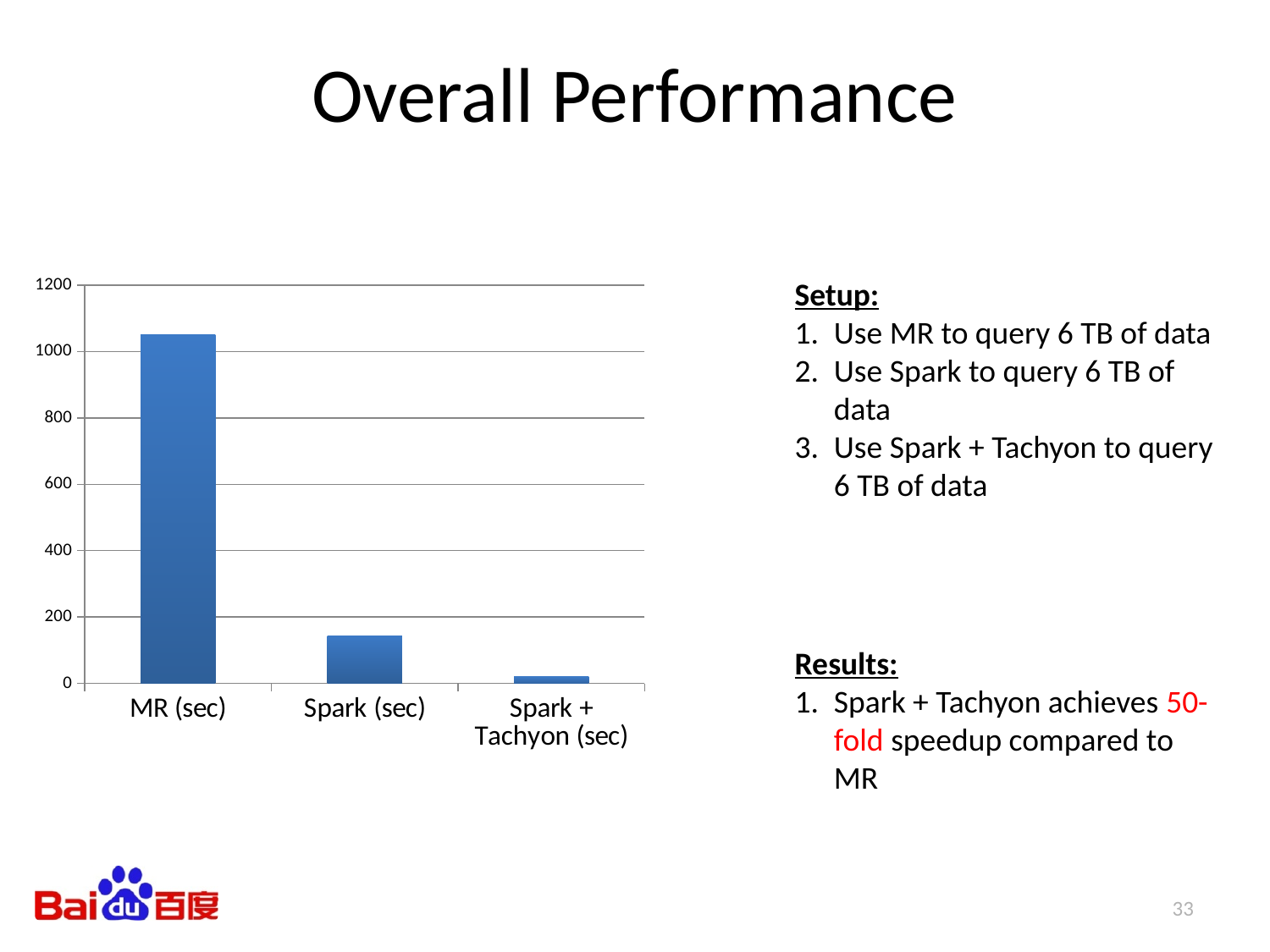
Which category has the lowest value in the chart? Spark + Tachyon (sec) Which is larger, the value for MR (sec) or the value for Spark (sec)? MR (sec) Which is larger, the value for Spark (sec) or the value for Spark + Tachyon (sec)? Spark (sec) What is the highest tick value shown on the vertical axis of the chart? 1200 How many categories are shown on the x axis of the chart? 3 Is the value for MR (sec) greater or less than 1000? greater Is the value for MR (sec) greater or less than 1200? less Which category has the highest value in the chart? MR (sec) Do the values rise or fall moving left to right along the x axis? fall Is the value for Spark + Tachyon (sec) greater or less than 200? less What kind of chart is shown on the slide? bar chart